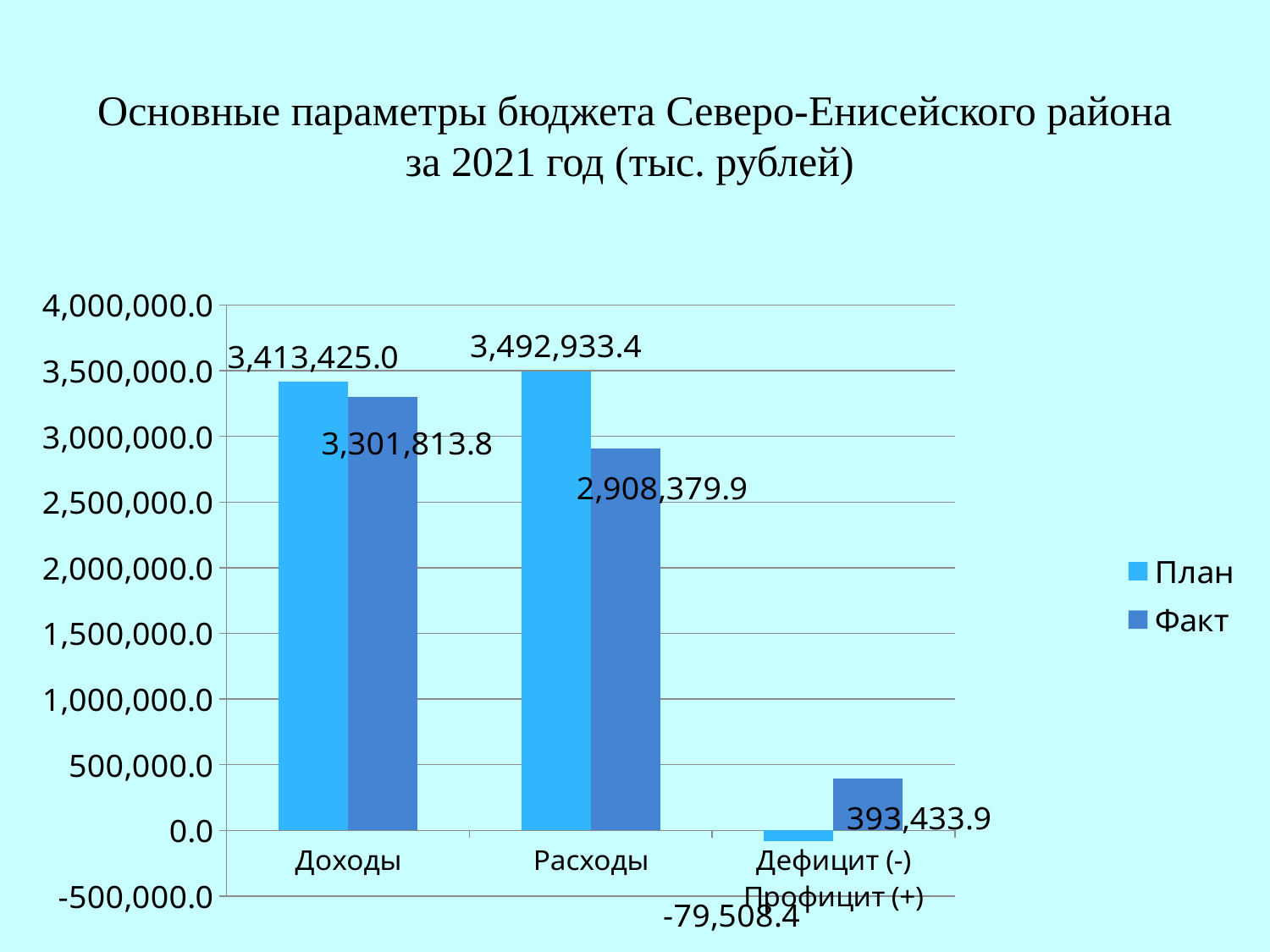
Which category has the highest План value? Расходы How many series does the legend list? 2 What is the Факт value for Расходы? 2,908,379.9 What is the План value for Дефицит (-) Профицит (+)? -79,508.4 What is the Факт value for Дефицит (-) Профицит (+)? 393,433.9 What is the План value for Доходы? 3,413,425.0 What is the difference between the План and Факт values for Доходы? 111,611.2 What kind of chart is shown on the slide? Bar chart What is the difference between the План and Факт values for Расходы? 584,553.5 How many categories are shown on the x axis? 3 For Расходы, which is larger: План or Факт? План Which category has the lowest Факт value? Дефицит (-) Профицит (+)